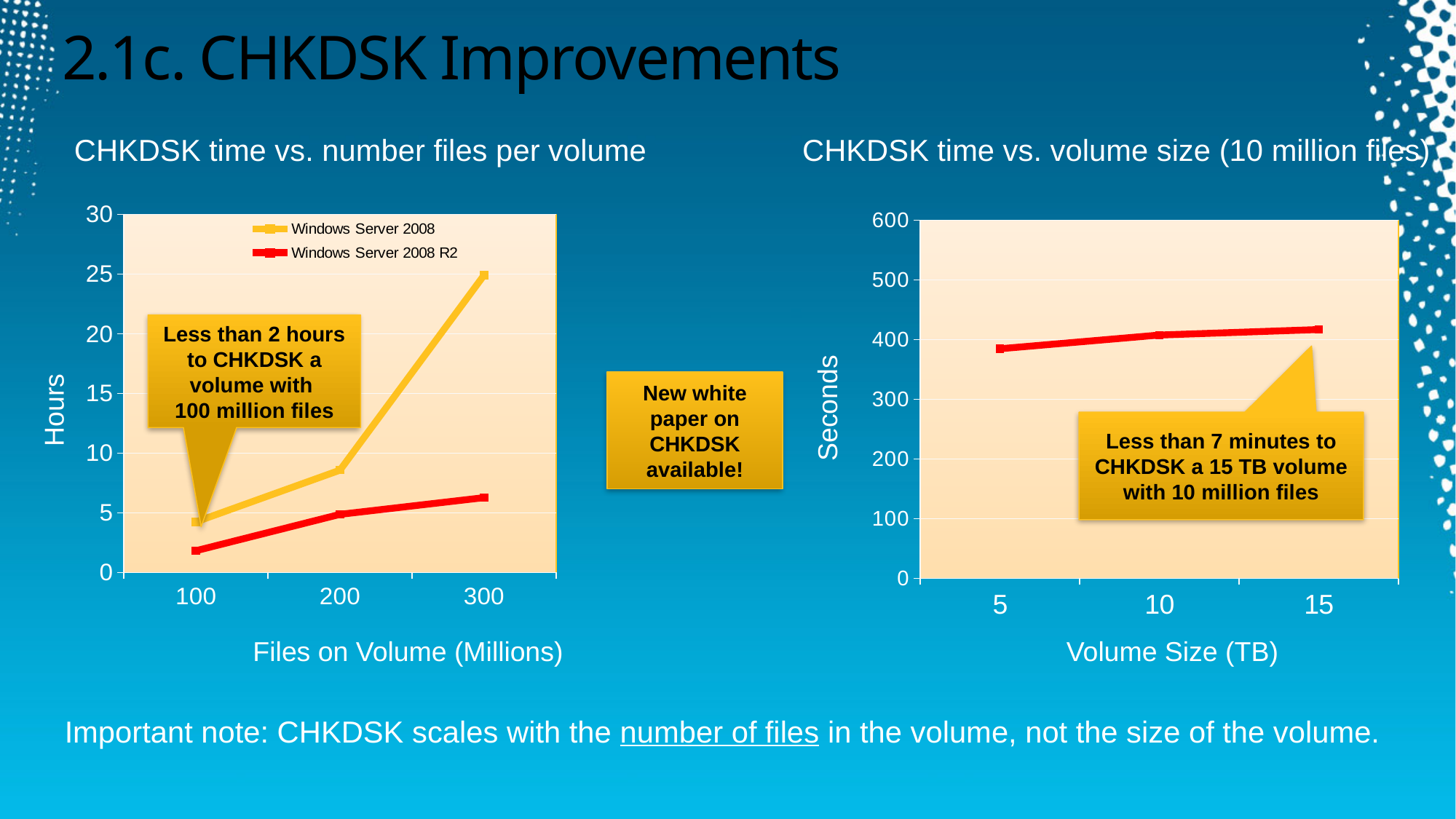
In the 'CHKDSK time vs. number files per volume' chart, how many points are plotted along the x axis for each series? 3 In the 'CHKDSK time vs. number files per volume' chart, is the Windows Server 2008 R2 value at 300 million files greater or less than 10 hours? less In the 'CHKDSK time vs. number files per volume' chart, which series has the higher value at 300 million files? Windows Server 2008 What is the x-axis label of the 'CHKDSK time vs. volume size (10 million files)' chart? Volume Size (TB) In the 'CHKDSK time vs. number files per volume' chart, is the Windows Server 2008 value at 300 million files greater or less than 20 hours? greater In the 'CHKDSK time vs. number files per volume' chart, how many series does the legend list? 2 In the 'CHKDSK time vs. number files per volume' chart, does the Windows Server 2008 line rise or fall as the number of files increases? rise In the 'CHKDSK time vs. volume size (10 million files)' chart, do the values rise or fall as volume size increases? rise What kind of chart is the 'CHKDSK time vs. number files per volume' chart? line chart What kind of chart is the 'CHKDSK time vs. volume size (10 million files)' chart? line chart In the 'CHKDSK time vs. volume size (10 million files)' chart, is the value at 5 TB greater or less than 300 seconds? greater In the 'CHKDSK time vs. volume size (10 million files)' chart, how many volume sizes are plotted? 3